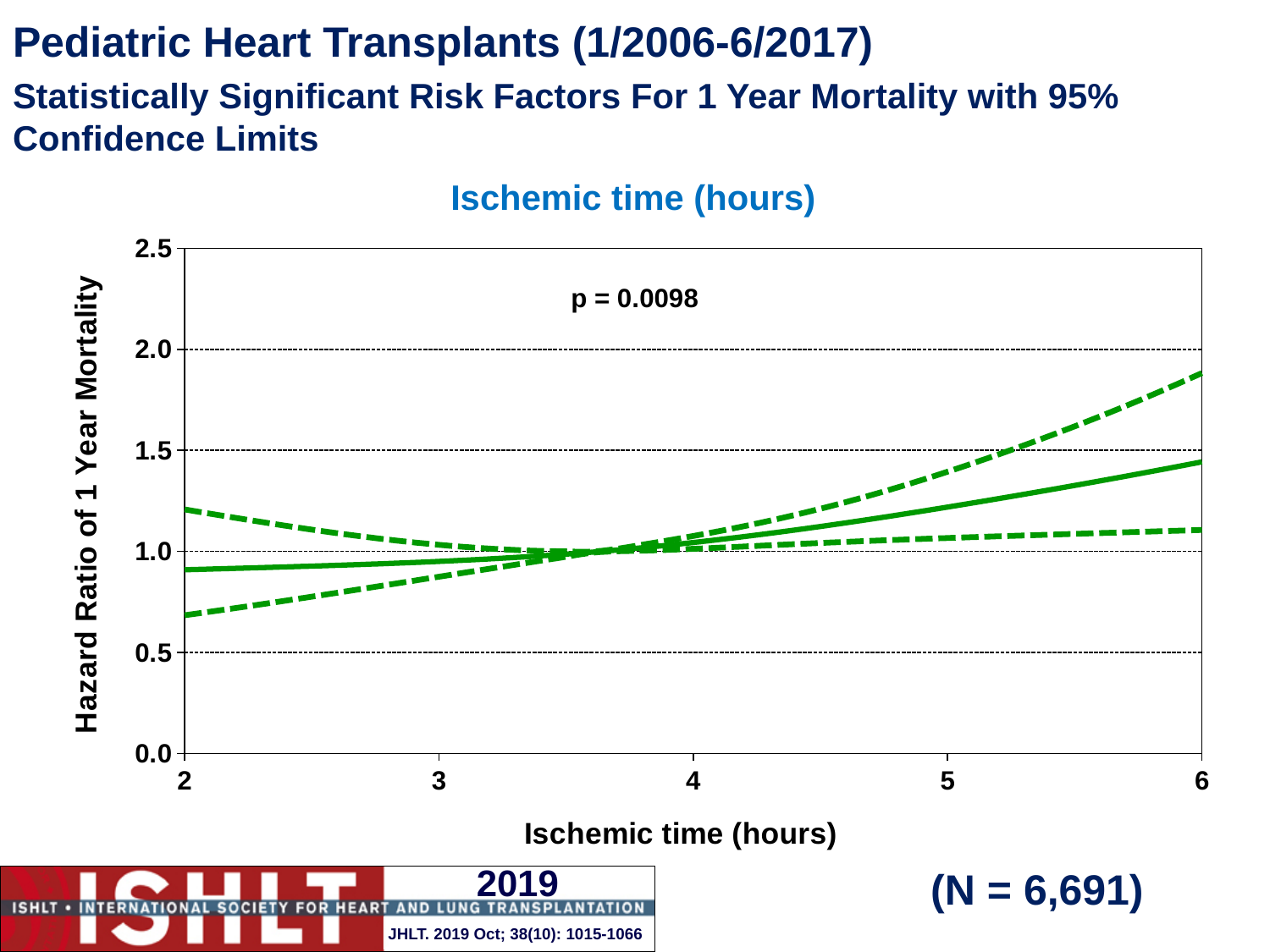
Is the hazard ratio (solid line) at 6 hours of ischemic time greater or less than 1.0? greater Is the lower 95% confidence limit (lower dashed line) at 6 hours greater or less than 1.5? less Is the upper 95% confidence limit (upper dashed line) at 6 hours greater or less than 1.5? greater What kind of chart is shown on the slide? line chart How many tick values are labeled on the x axis of the chart? 5 How many lines are plotted on the chart? 3 What is the label of the y axis of the chart? Hazard Ratio of 1 Year Mortality What is the p-value shown on the chart? p = 0.0098 Does the solid hazard ratio line rise or fall as ischemic time increases from 2 to 6 hours? rise